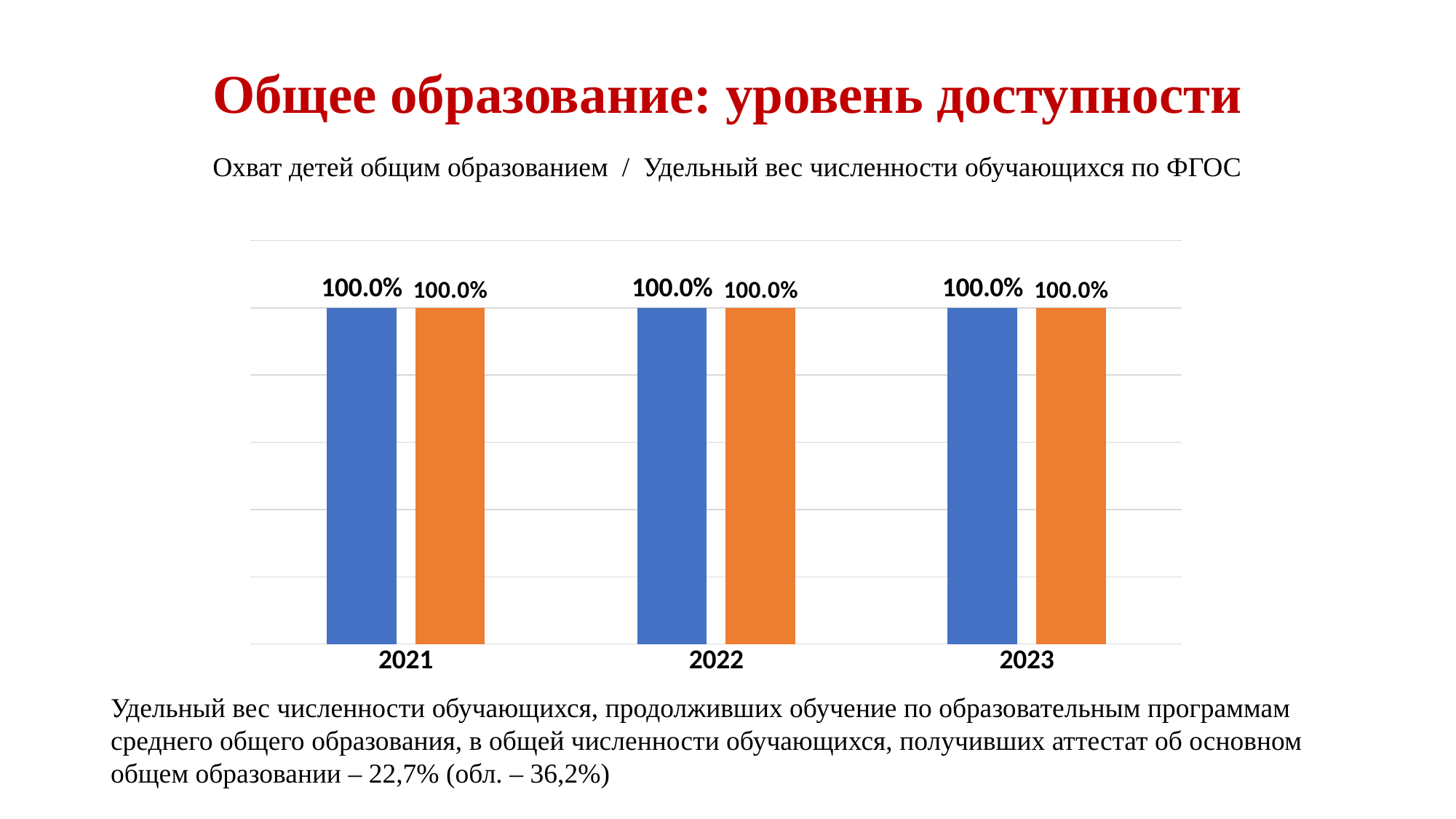
What is the value of the blue bar for 2021? 100.0% How many bars are shown for each year in the chart? 2 What is the value of the orange bar for 2021? 100.0% What is the value of the blue bar for 2023? 100.0% What is the difference between the blue bar and the orange bar for 2023? 0.0% What type of chart is shown on the slide? bar chart What two colours are used for the bars in the chart? blue and orange How many years are shown on the x axis of the chart? 3 Which years are labelled on the x axis of the chart? 2021, 2022, 2023 Do the values of the blue bars rise, fall, or stay the same from 2021 to 2023? stay the same Is the blue bar for 2022 larger than, smaller than, or equal to the orange bar for 2022? equal What is the value of the orange bar for 2022? 100.0%